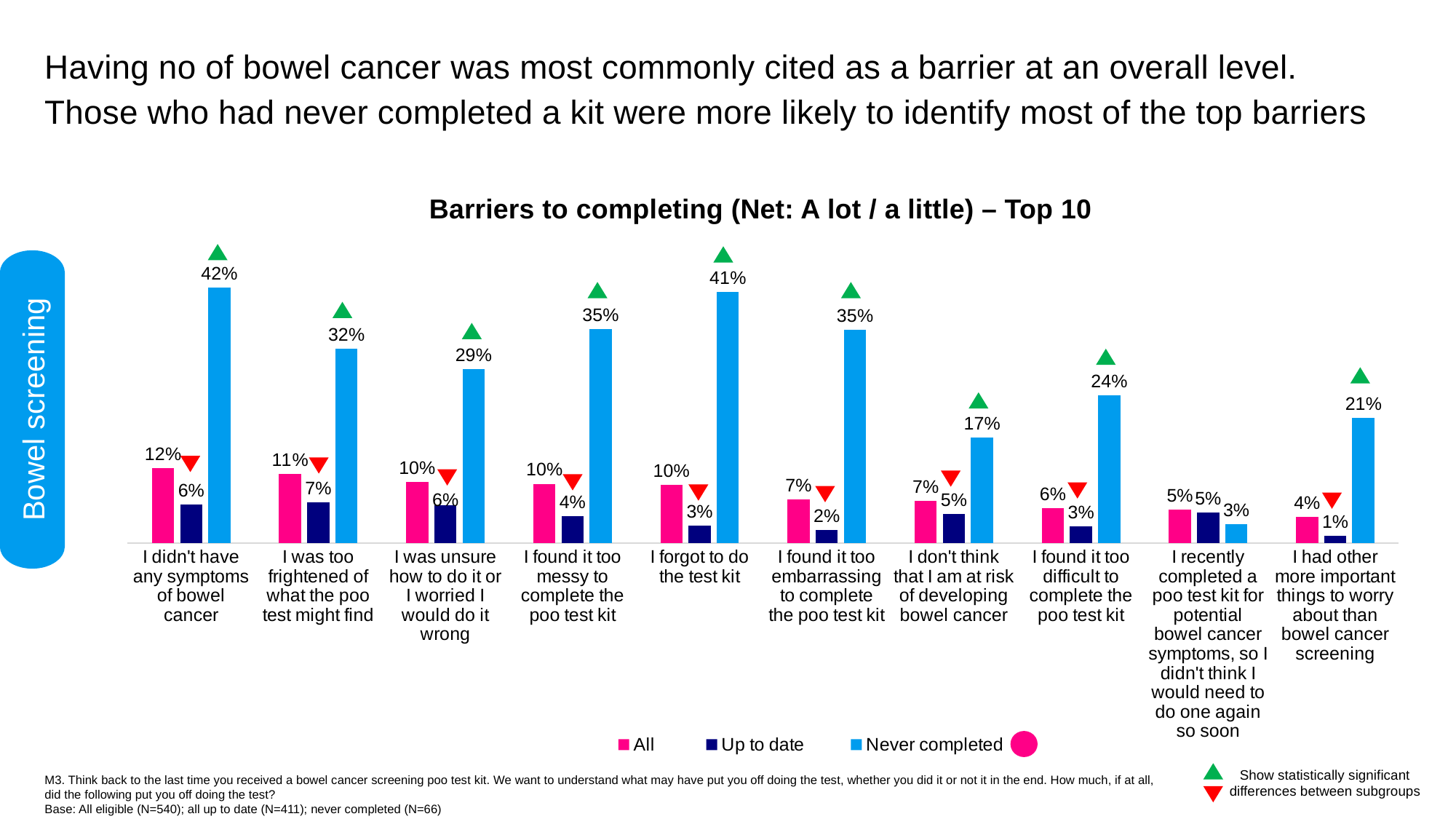
What is the title of the chart? Barriers to completing (Net: A lot / a little) – Top 10 How many series does the legend list? 3 What is the 'Never completed' value for 'I had other more important things to worry about than bowel cancer screening'? 21% Which category has the highest 'Never completed' value? I didn't have any symptoms of bowel cancer What is the 'Up to date' value for 'I found it too embarrassing to complete the poo test kit'? 2% For 'I recently completed a poo test kit for potential bowel cancer symptoms, so I didn't think I would need to do one again so soon', which is larger: the 'All' value or the 'Never completed' value? All What is the 'Never completed' value for 'I didn't have any symptoms of bowel cancer'? 42% How many categories are shown on the x axis? 10 What kind of chart is shown on the slide? Bar chart What is the 'All' value for 'I was too frightened of what the poo test might find'? 11% Which category has the lowest 'Up to date' value? I had other more important things to worry about than bowel cancer screening What is the difference between the 'Never completed' and 'All' values for 'I forgot to do the test kit'? 31%